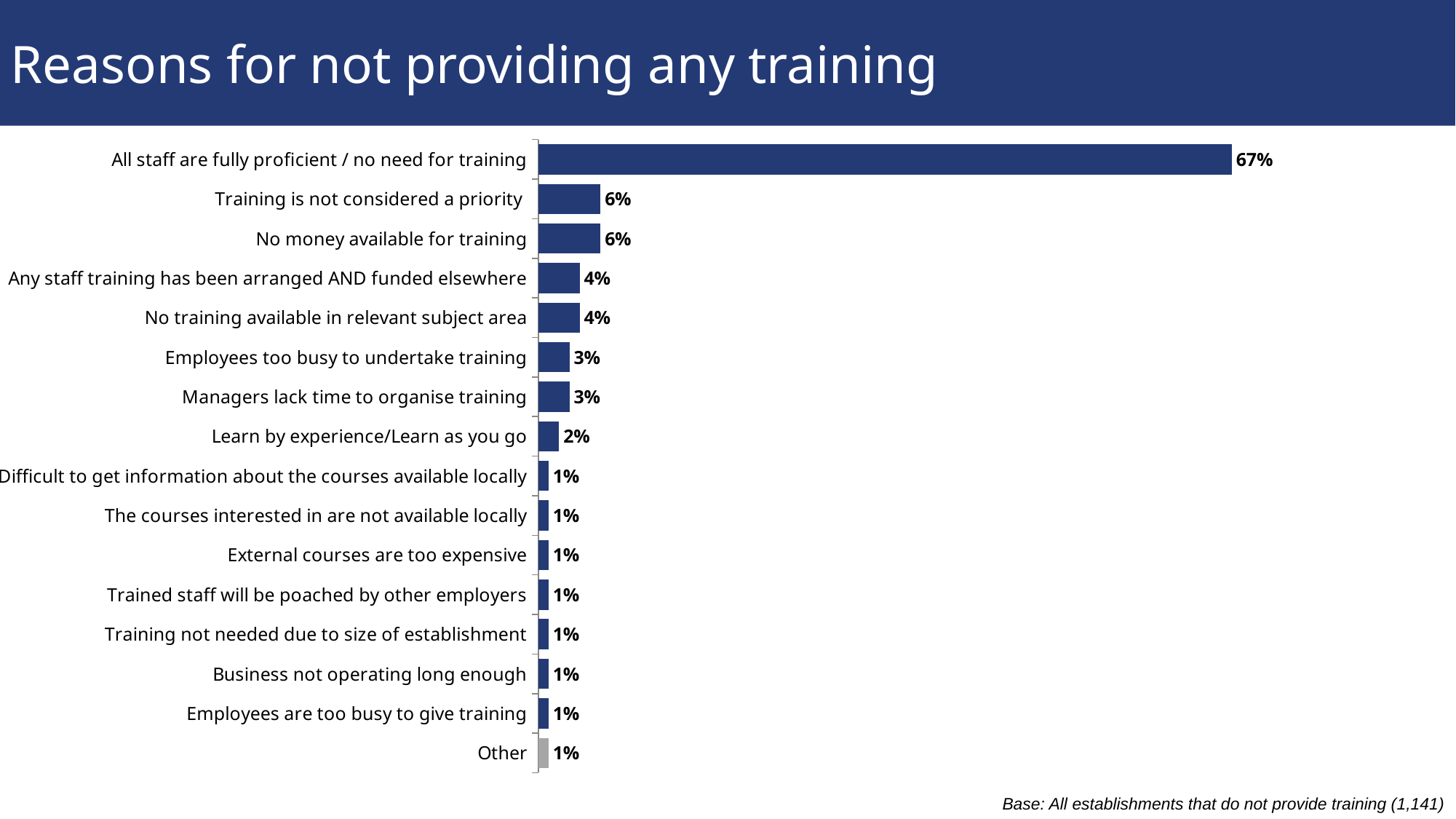
Which bar is shown in grey rather than dark blue? Other What percentage of establishments gave 'All staff are fully proficient / no need for training' as a reason for not providing training? 67% Which is larger: the value for 'Training is not considered a priority' or the value for 'Managers lack time to organise training'? Training is not considered a priority What is the value for 'Learn by experience/Learn as you go'? 2% What is the difference between 'All staff are fully proficient / no need for training' and 'No money available for training'? 61 percentage points What is the title of the slide? Reasons for not providing any training Which reason has the highest percentage? All staff are fully proficient / no need for training What is the difference between 'Any staff training has been arranged AND funded elsewhere' and 'Learn by experience/Learn as you go'? 2 percentage points What is the value for 'Employees too busy to undertake training'? 3% How many reasons (categories) are shown in the chart? 16 What is the value for 'Training is not considered a priority'? 6% What type of chart is shown on the slide? Bar chart